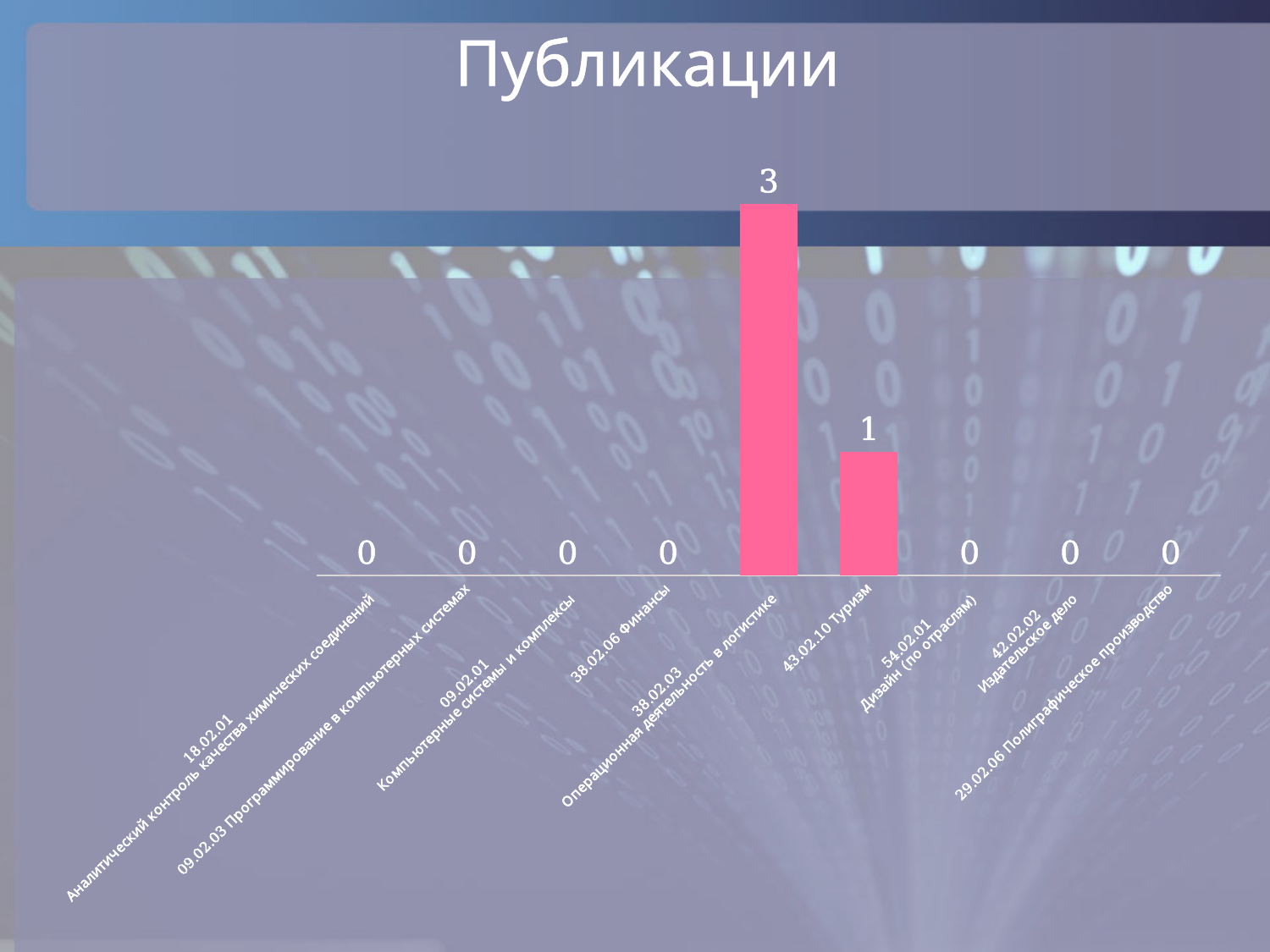
What is the title of the slide containing the chart? Публикации Which is larger, the value for 43.02.10 Туризм or the value for 54.02.01 Дизайн (по отраслям)? 43.02.10 Туризм What colour are the bars in the chart? pink What kind of chart is shown on the slide? bar chart Which category has the highest value? 38.02.03 Операционная деятельность в логистике How many categories have a value of 0? 7 What is the value for 43.02.10 Туризм? 1 What is the difference between the values for 38.02.03 Операционная деятельность в логистике and 43.02.10 Туризм? 2 How many categories are shown on the x axis? 9 What is the value for 38.02.06 Финансы? 0 What is the value for 42.02.02 Издательское дело? 0 What is the value for 38.02.03 Операционная деятельность в логистике? 3